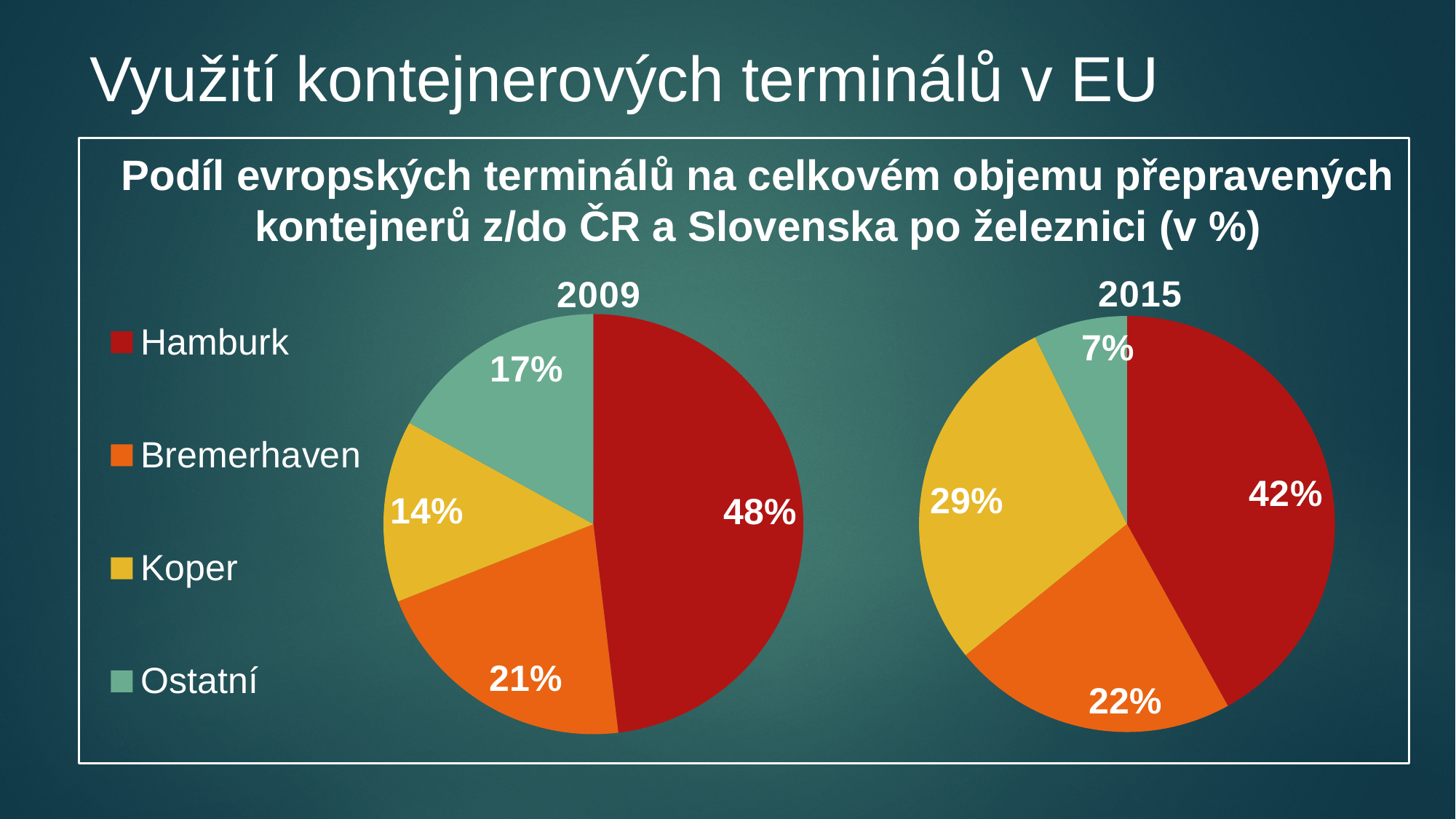
In the 2015 pie chart, which is larger: Koper or Bremerhaven? Koper In the 2009 pie chart, what share does Hamburk have? 48% What kind of charts are shown on the slide? Pie charts In the 2015 pie chart, what share does Koper have? 29% In the 2009 pie chart, which category has the smallest share? Koper In the 2015 pie chart, what share does Bremerhaven have? 22% Which colour represents Hamburk in the pie charts? Red In the 2015 pie chart, which category has the smallest share? Ostatní In the 2009 pie chart, which category has the largest share? Hamburk How many categories does the legend list? 4 What is the difference between Koper's share in 2015 and in 2009? 15% In the 2009 pie chart, what share does Ostatní have? 17%